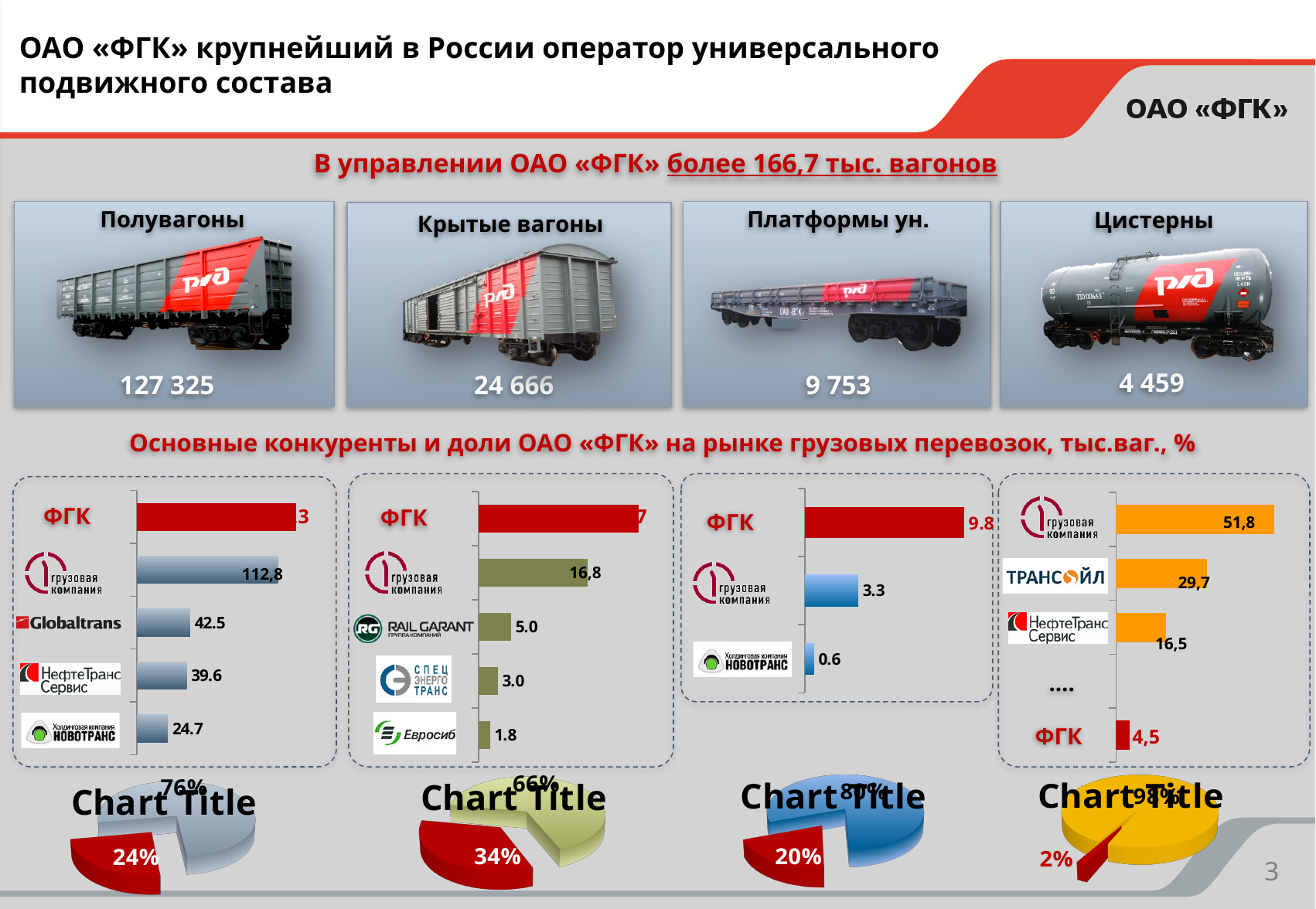
In the bar chart for Платформы ун. (third from left), which company has the highest value? ФГК In the bar chart for Цистерны (rightmost), what is the value for Трансойл? 29,7 In the bar chart for Цистерны (rightmost), which company has the lowest value? ФГК In the bar chart for Полувагоны (leftmost), what is the value for Globaltrans? 42.5 How many bars are in the bar chart for Платформы ун. (third from left)? 3 How many bars are in the bar chart for Полувагоны (leftmost)? 5 In the bar chart for Крытые вагоны (second from left), which is larger: the value for Rail Garant or the value for Евросиб? Rail Garant In the bar chart for Платформы ун. (third from left), what is the value for ФГК? 9.8 In the bar chart for Крытые вагоны (second from left), what is the value for Евросиб? 1.8 What type of chart is used to show the competitors for Крытые вагоны (second from left)? bar chart In the bar chart for Полувагоны (leftmost), what is the difference between the values for Globaltrans and НефтеТранс Сервис? 2.9 In the pie chart below the Цистерны bar chart (rightmost pie), what share does the red slice represent? 2%